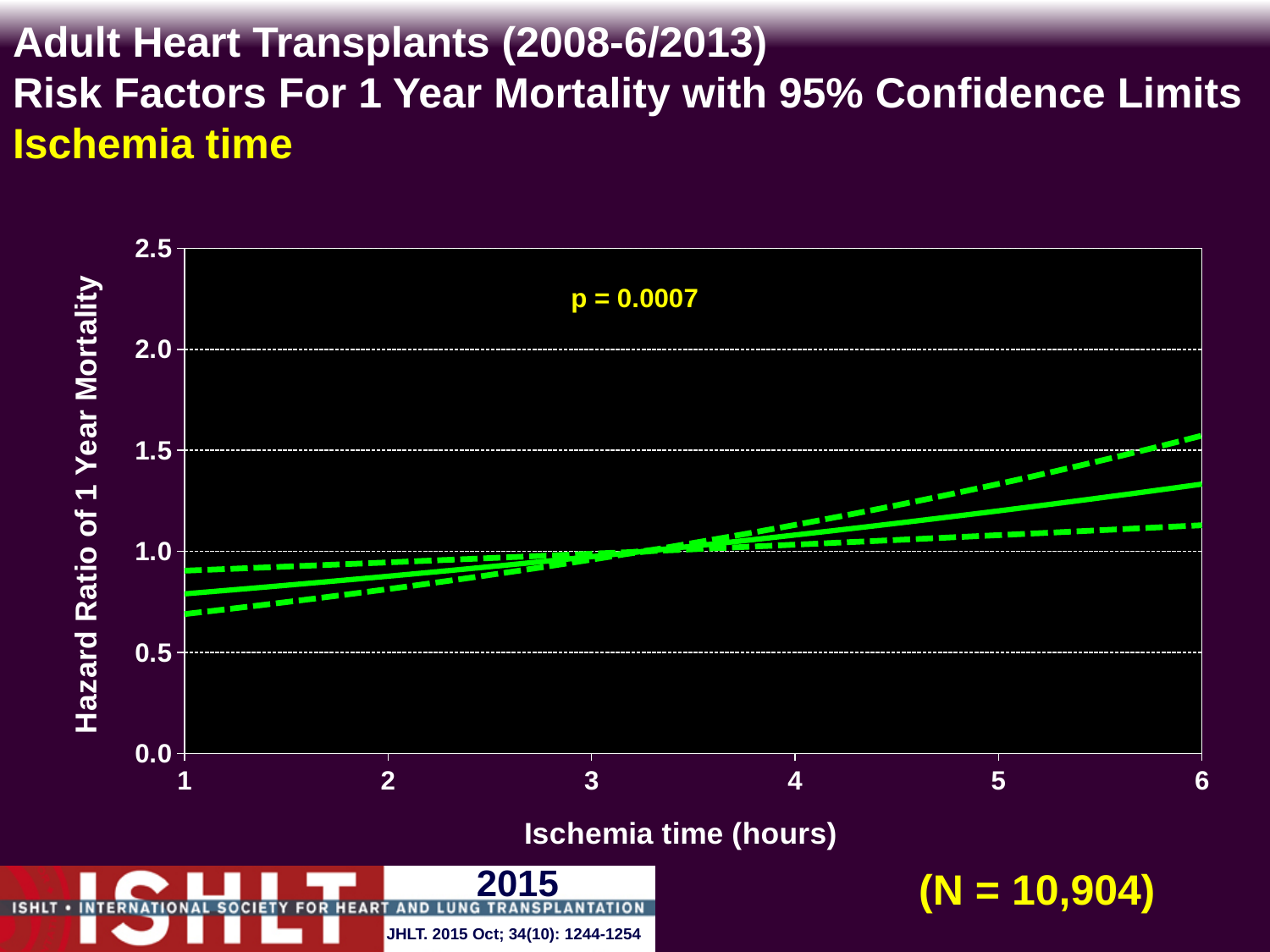
How many lines are plotted on the chart? 3 What kind of chart is shown on the slide? Line chart Is the hazard ratio at an ischemia time of 6 hours larger or smaller than at 1 hour? Larger What is the label of the x axis? Ischemia time (hours) Is the hazard ratio (solid line) at an ischemia time of 6 hours greater or less than 1.5? less Does the hazard ratio of 1 year mortality rise or fall as ischemia time increases from 1 to 6 hours? Rise Is the upper 95% confidence limit at an ischemia time of 6 hours greater or less than 1.5? greater Is the hazard ratio (solid line) at an ischemia time of 1 hour greater or less than 1.0? less What is the p-value shown on the chart? p = 0.0007